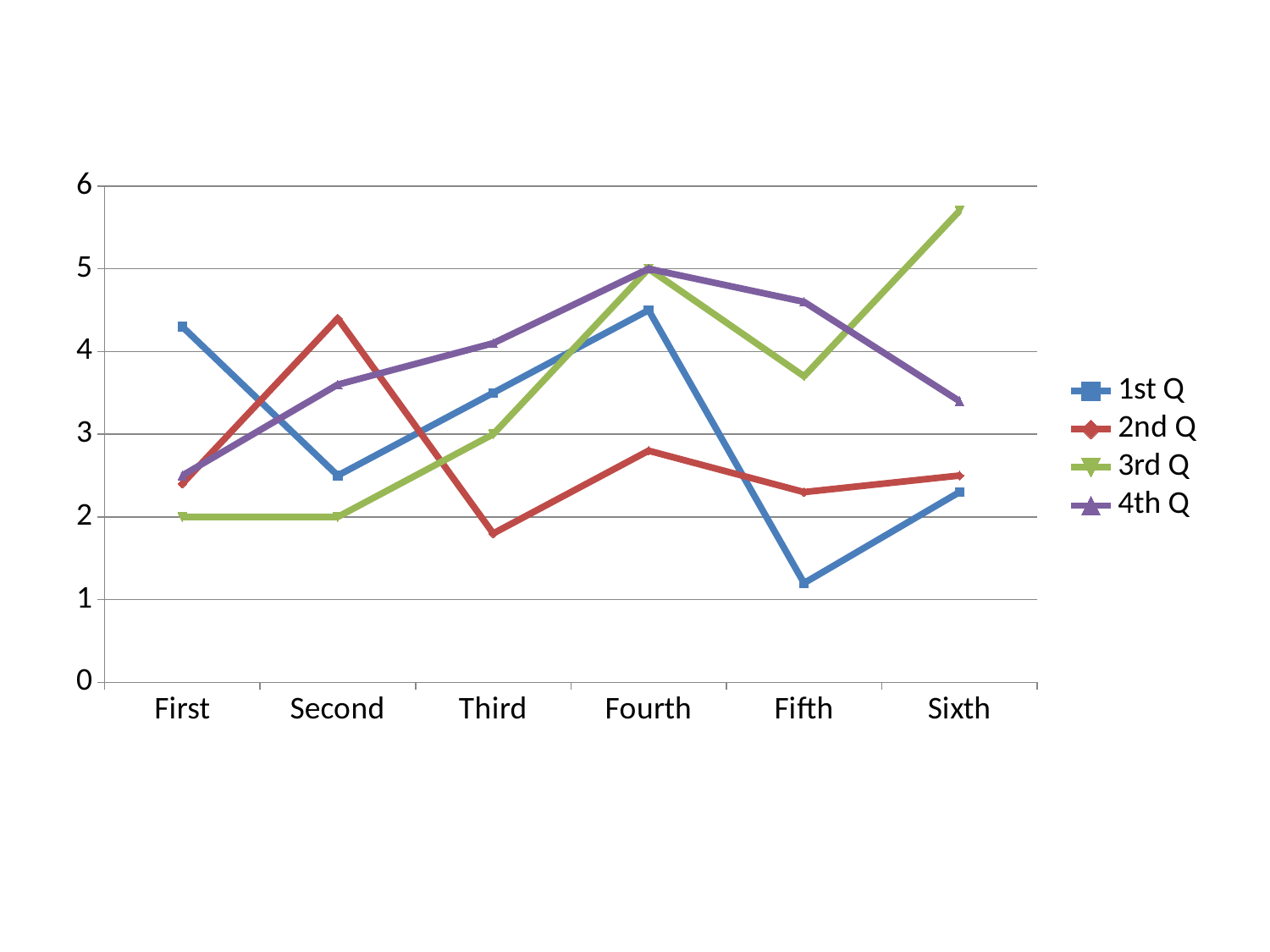
At which category does 3rd Q reach its highest value? Sixth How many series does the legend list? 4 Which series is shown in green in the legend? 3rd Q Is the value of 2nd Q at Second greater or less than 4? greater At Fifth, which is larger: 4th Q or 1st Q? 4th Q At which category does 1st Q reach its lowest value? Fifth What is the value of 3rd Q at Third? 3 What kind of chart is shown on the slide? line chart Is the value of 3rd Q at Sixth greater or less than 5? greater What is the value of 3rd Q at First? 2 Is the value of 1st Q at Fifth greater or less than 2? less How many categories are shown on the x axis? 6